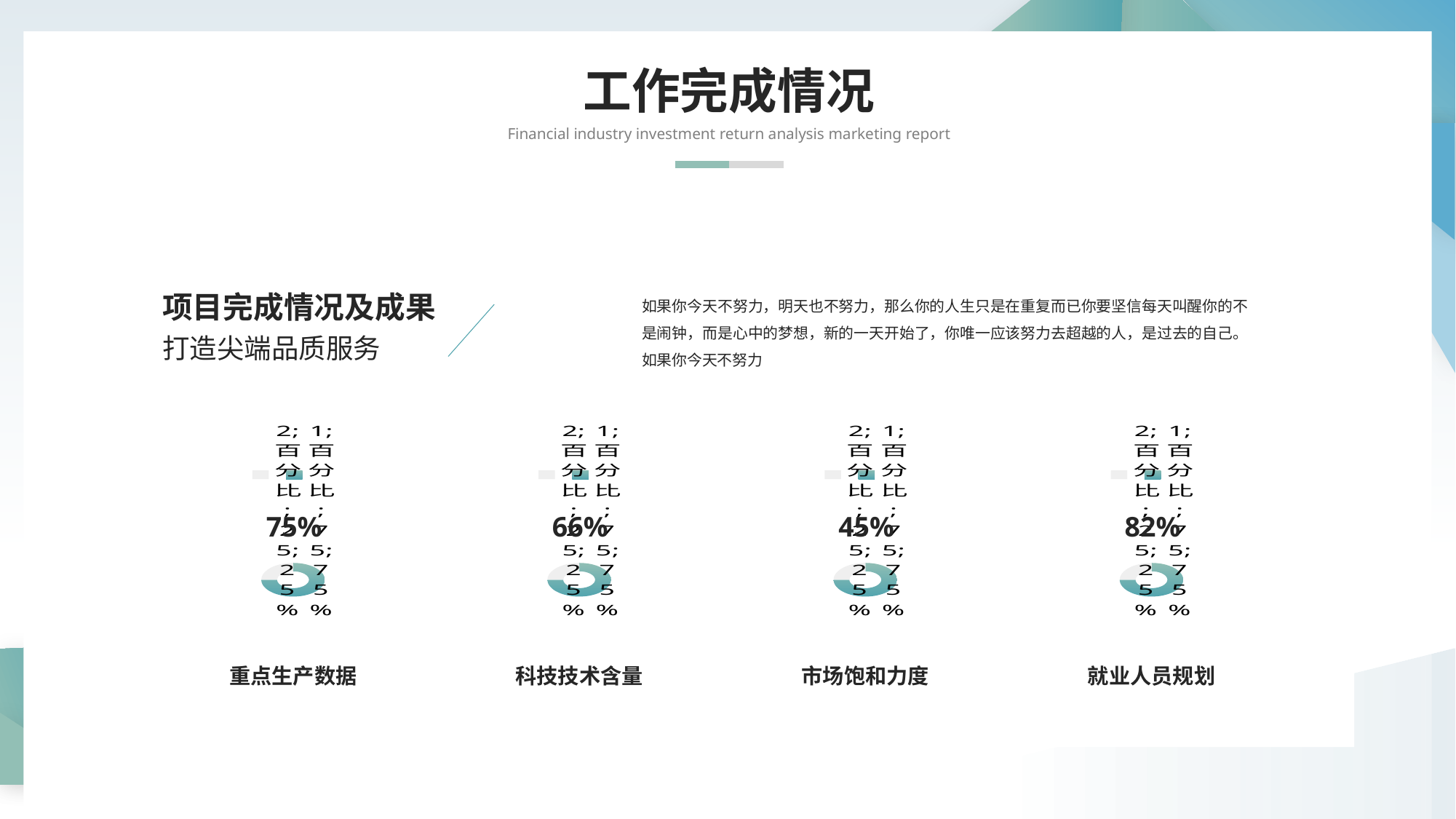
In the doughnut chart under 重点生产数据, what share does the larger slice (category 1) hold? 75% In the doughnut chart under 重点生产数据, which slice is larger, category 1 or category 2? category 1 In the doughnut chart under 重点生产数据, what share does the smaller slice (category 2) hold? 25% What kind of chart is used under the caption 重点生产数据? doughnut chart How many slices does the doughnut chart under 就业人员规划 have? 2 How many slices does the doughnut chart under 科技技术含量 have? 2 How many doughnut charts are shown on the slide? 4 What colour is the larger slice in each doughnut chart? teal What caption appears below the third doughnut chart from the left? 市场饱和力度